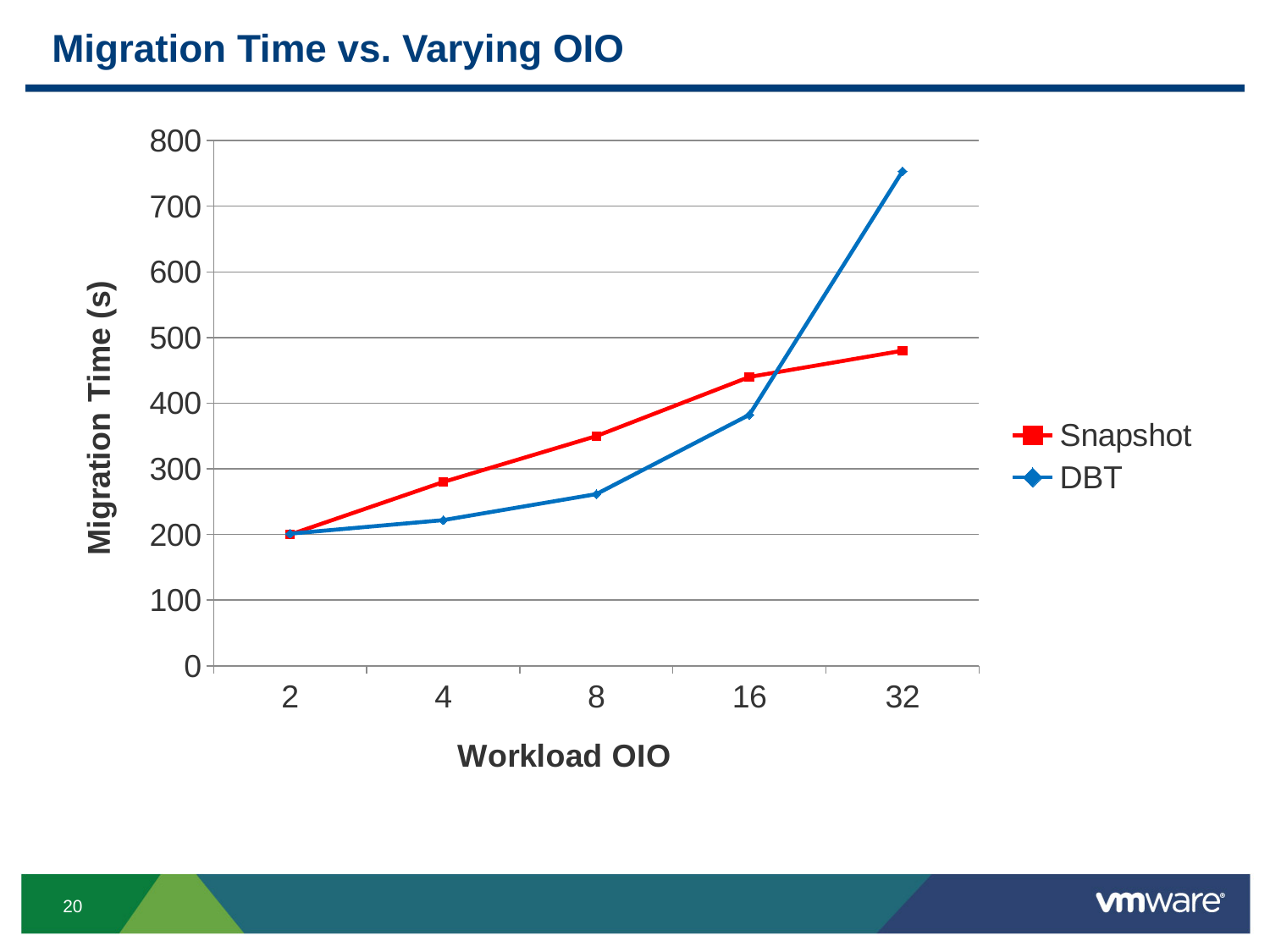
Which series has the higher migration time at Workload OIO 32, Snapshot or DBT? DBT Is the Snapshot migration time at Workload OIO 16 greater or less than 400? greater Is the DBT migration time at Workload OIO 32 greater or less than 700? greater Does the Snapshot migration time rise or fall as Workload OIO increases? rise What kind of chart is shown on the slide? line chart Is the DBT migration time at Workload OIO 8 greater or less than 300? less At which Workload OIO is the DBT migration time highest? 32 How many Workload OIO values are plotted along the x axis? 5 How many series does the legend list? 2 Which series has the higher migration time at Workload OIO 8, Snapshot or DBT? Snapshot